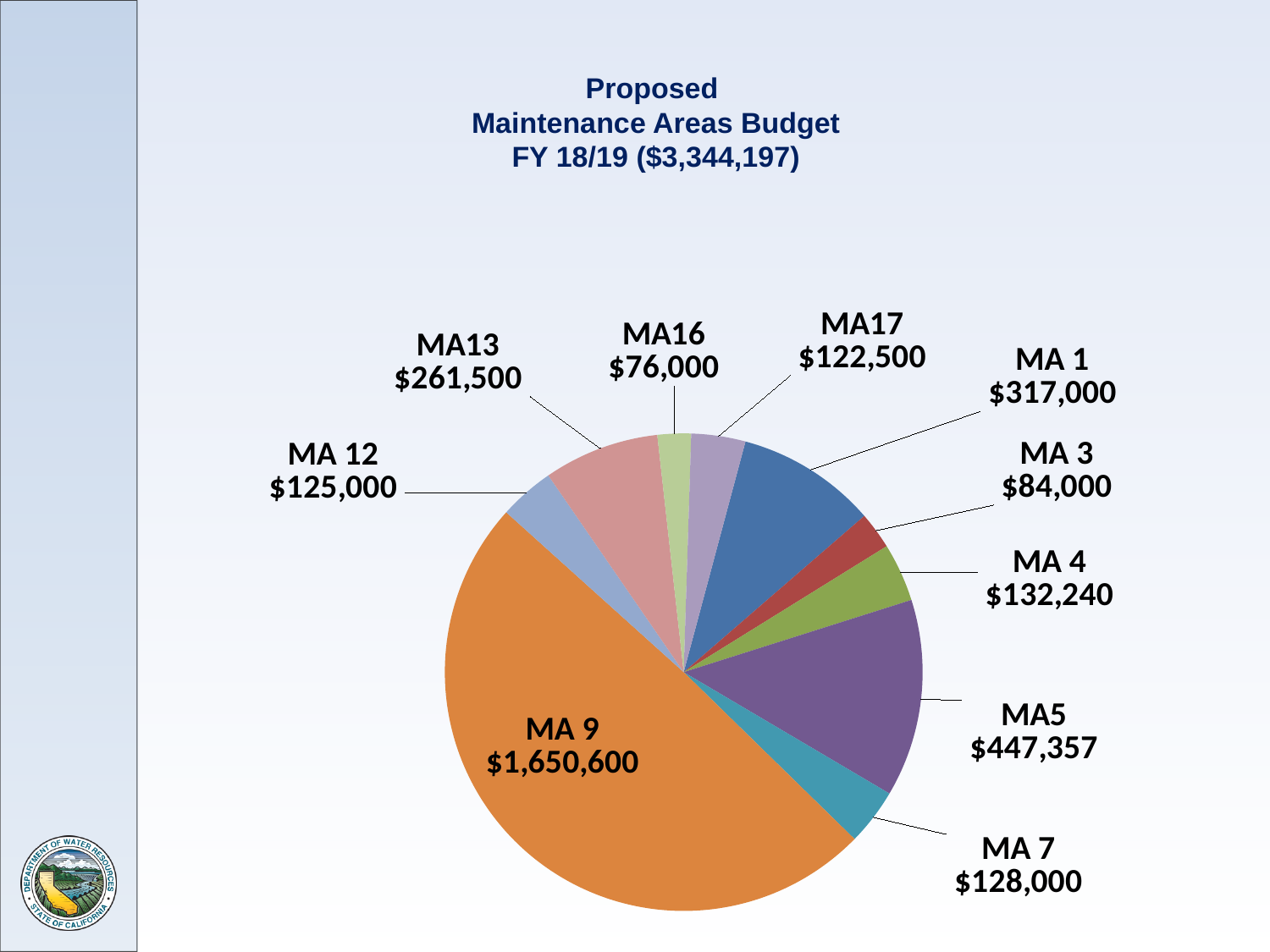
What is the total budget shown in the chart title? $3,344,197 What is the proposed budget for MA17? $122,500 How many maintenance areas are shown in the pie chart? 10 Which maintenance area has the smallest budget? MA16 Which has a larger budget, MA5 or MA13? MA5 What is the proposed budget for MA 4? $132,240 What is the proposed budget for MA 9? $1,650,600 What share of the total budget does MA 9 represent? 49.4% Which maintenance area has the largest budget? MA 9 What is the proposed budget for MA5? $447,357 What is the difference between the budgets for MA 1 and MA 3? $233,000 What kind of chart is shown on the slide? pie chart